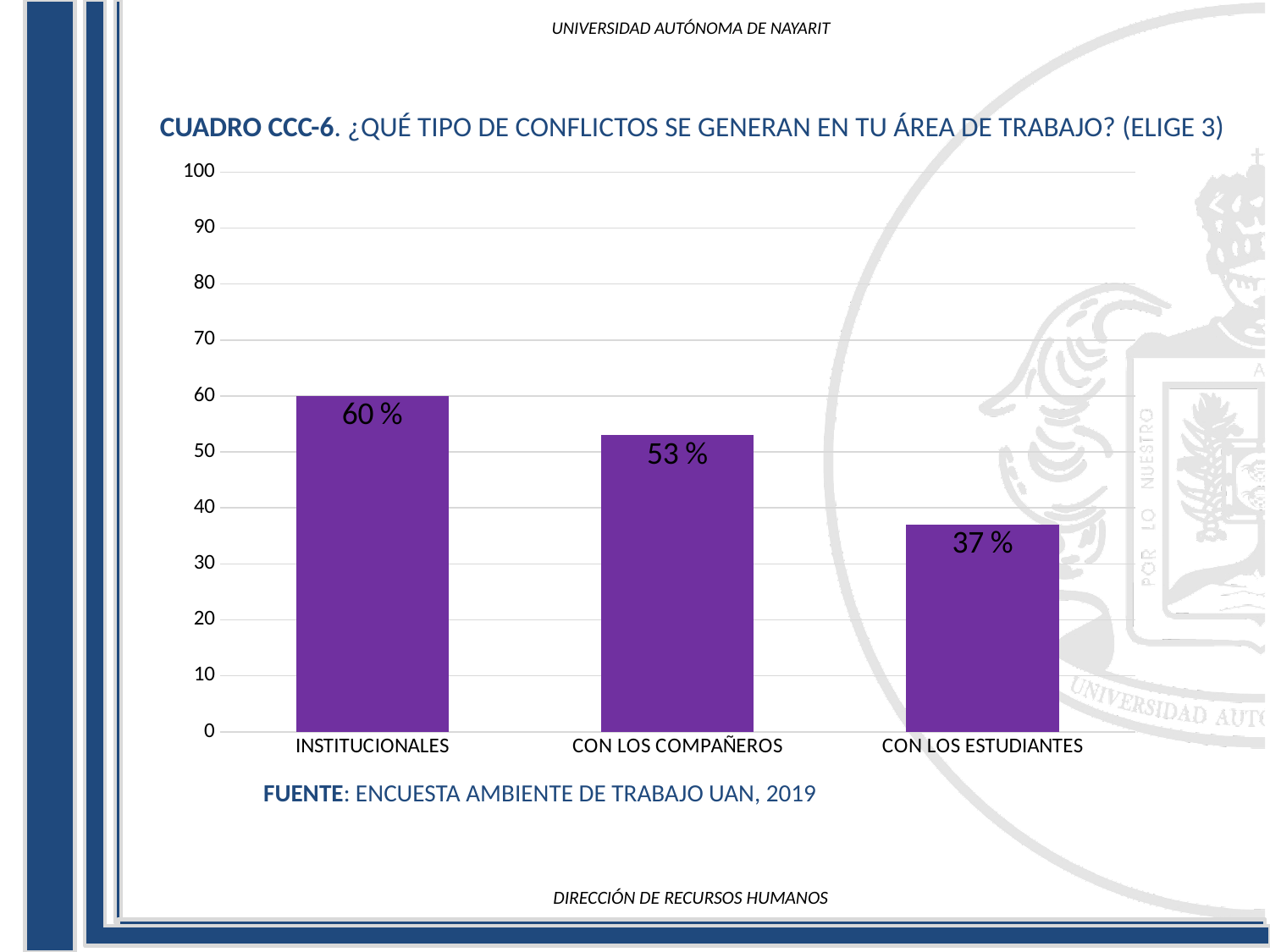
What is the value for INSTITUCIONALES? 60 % What kind of chart is shown on the slide? bar chart What is the difference between the values for INSTITUCIONALES and CON LOS ESTUDIANTES? 23 % What is the value for CON LOS COMPAÑEROS? 53 % Is the value for CON LOS ESTUDIANTES greater or less than 40? less Which category has the highest value? INSTITUCIONALES What is the difference between the values for CON LOS COMPAÑEROS and CON LOS ESTUDIANTES? 16 % Which category has the lowest value? CON LOS ESTUDIANTES What is the value for CON LOS ESTUDIANTES? 37 % Which is larger, the value for INSTITUCIONALES or the value for CON LOS COMPAÑEROS? INSTITUCIONALES How many categories are shown on the x axis? 3 What is the source cited below the chart? ENCUESTA AMBIENTE DE TRABAJO UAN, 2019